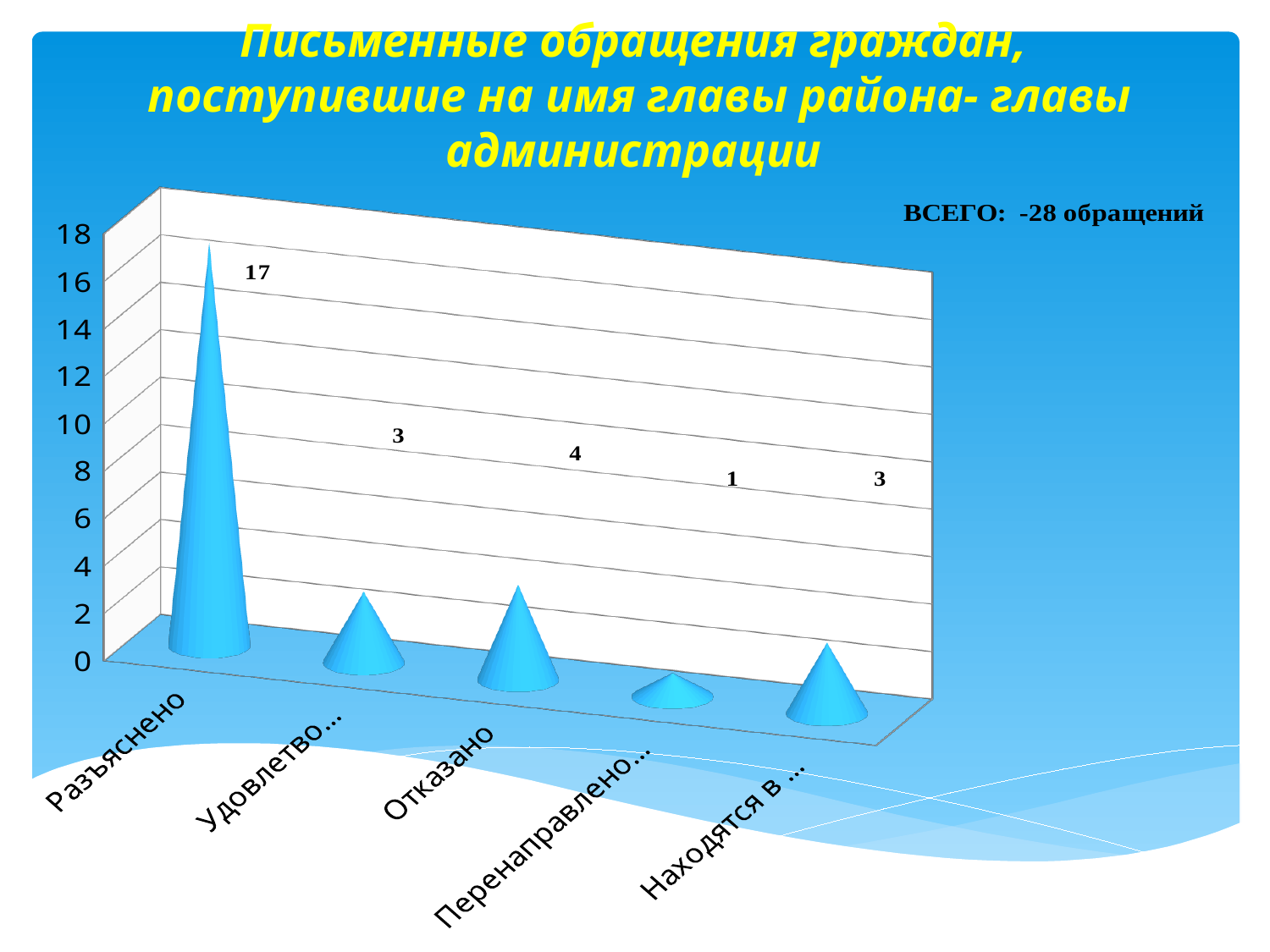
What is the value for Разъяснено? 17 Which category has the highest value? Разъяснено What is the total of all the values shown in the chart? 28 What kind of chart is shown on the slide? bar chart Which category has the lowest value? Перенаправлено… What is the value for the category labelled Перенаправлено…? 1 What is the difference between the values for Разъяснено and Отказано? 13 How many categories are shown on the x axis? 5 Which is larger, the value for Отказано or the value for the category labelled Удовлетво…? Отказано What is the value for Отказано? 4 What is the highest tick value shown on the vertical axis? 18 Is the value for Разъяснено greater or less than 10? greater